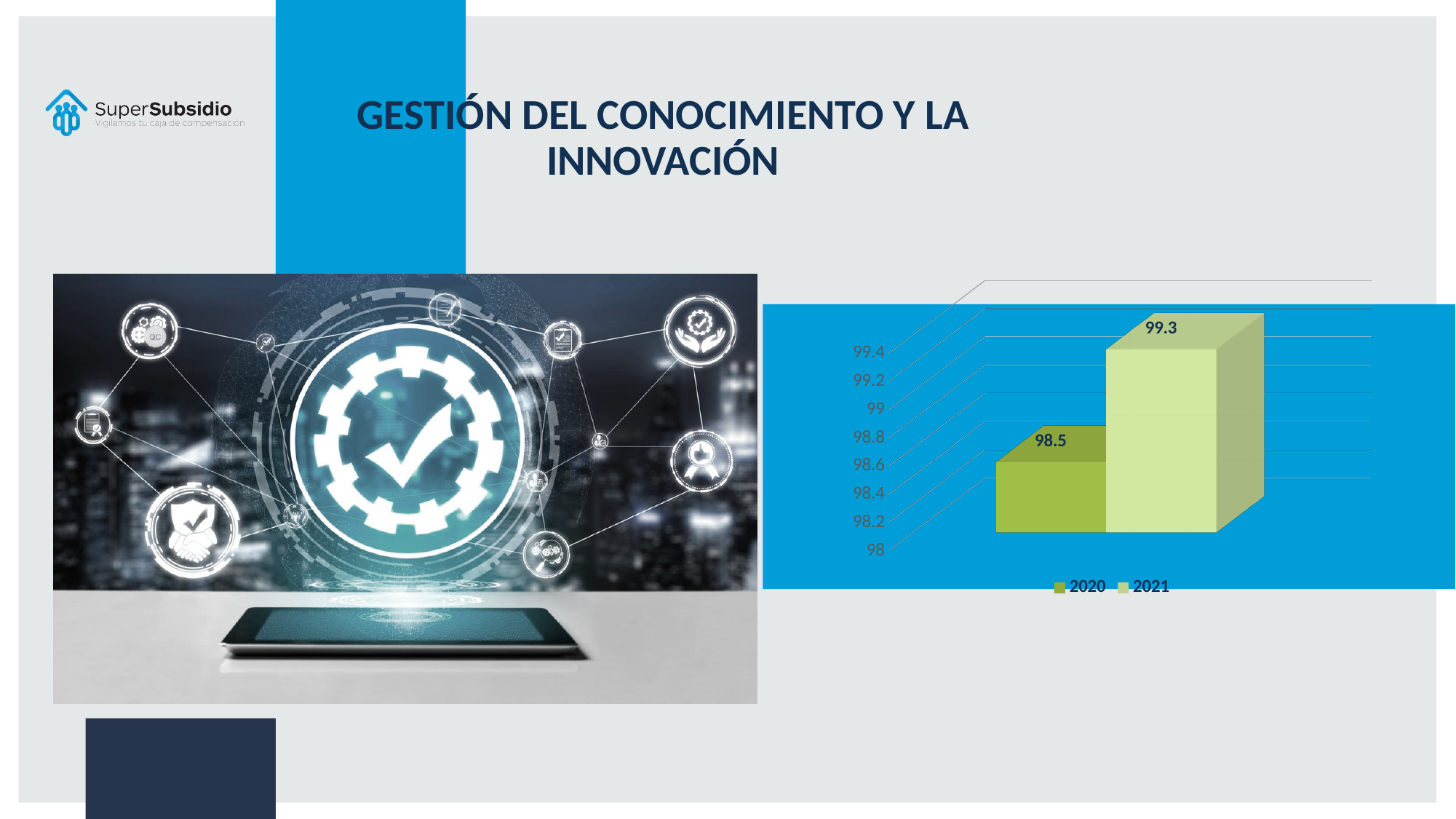
What is the value for 2020? 98.5 Which year has the higher value? 2021 Is the value for 2021 larger than the value for 2020? Yes What kind of chart is shown on the slide? Bar chart How many series does the legend list? 2 Does the value rise or fall from 2020 to 2021? Rise Which year has the lower value? 2020 What is the difference between the 2021 and 2020 values? 0.8 What is the value for 2021? 99.3 Is the value for 2021 greater or less than 99? greater How many bars are plotted in the chart? 2 Is the value for 2020 greater or less than 99? less